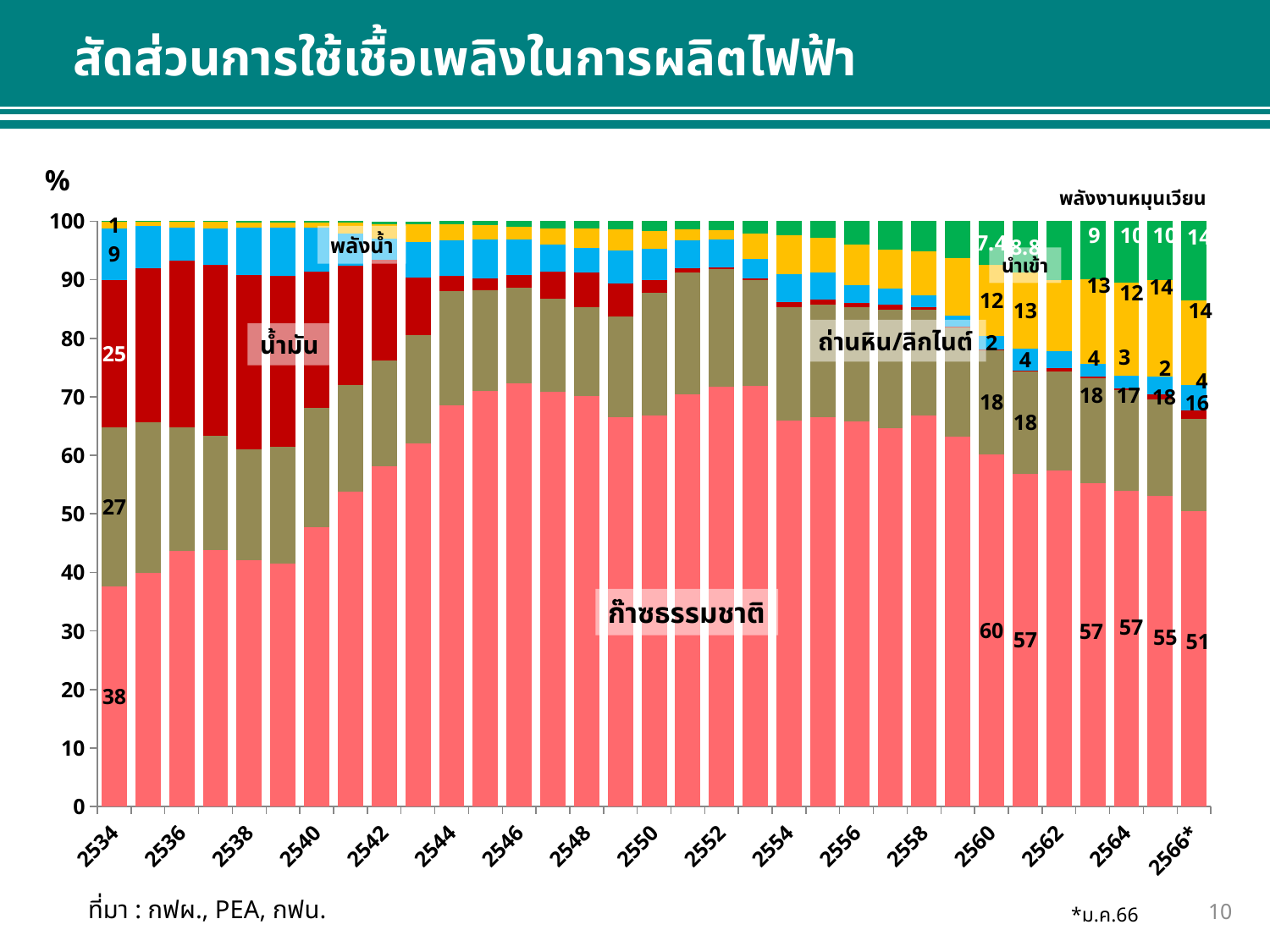
What is the share of oil (น้ำมัน) in 2534? 25 What is the share of renewable energy (พลังงานหมุนเวียน) in 2566*? 14 By how much did the natural gas share fall from 2534 to 2566*? 13 Is the natural gas share in 2540 greater or less than 50? less What is the share of natural gas (ก๊าซธรรมชาติ) in 2566*? 51 How many fuel types are labelled in the chart? 6 Which year has the larger natural gas share, 2534 or 2566*? 2566* What is the share of natural gas (ก๊าซธรรมชาติ) in 2534? 38 What is the share of hydro (พลังน้ำ) in 2534? 9 What kind of chart is shown on the slide? Stacked bar chart Does the share of oil (น้ำมัน) rise or fall over the years shown? Fall What is the share of coal/lignite (ถ่านหิน/ลิกไนต์) in 2534? 27